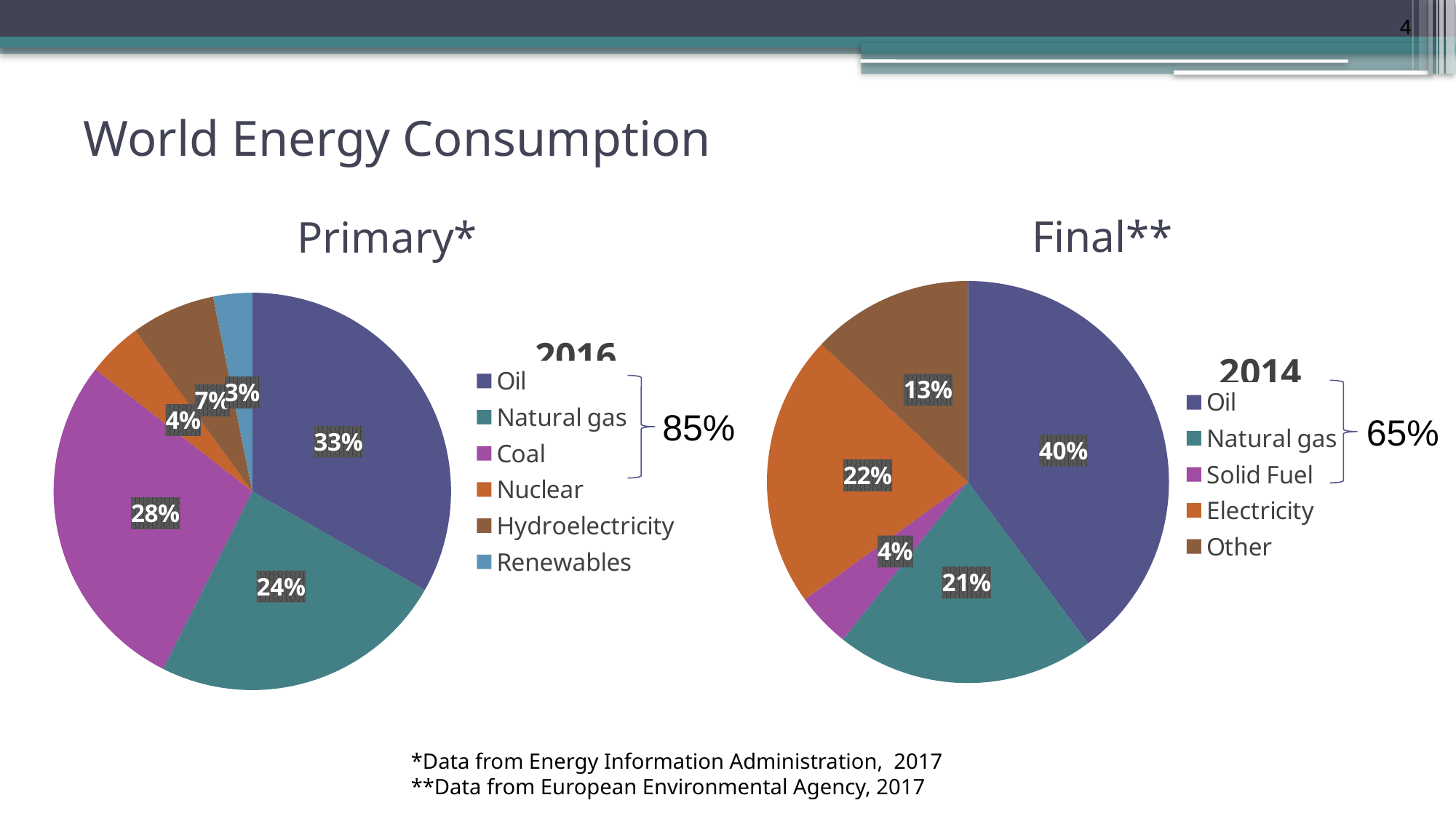
In the Final pie chart, what is the difference between the Oil share and the Solid Fuel share? 36% In the Primary pie chart, which category has the largest share? Oil How many categories does the legend of the Primary pie chart list? 6 In the Primary pie chart, what share does Coal have? 28% What kind of charts are shown on the slide? Pie charts In the Primary pie chart, what is the difference between the Coal share and the Natural gas share? 4% In the Primary pie chart, what share does Oil have? 33% In the Final pie chart, what share does Electricity have? 22% What year is shown in the legend heading of the Final pie chart? 2014 In the Final pie chart, which category has the largest share? Oil In the Final pie chart, which is larger, Natural gas or Other? Natural gas In the Primary pie chart, which category has the smallest share? Renewables